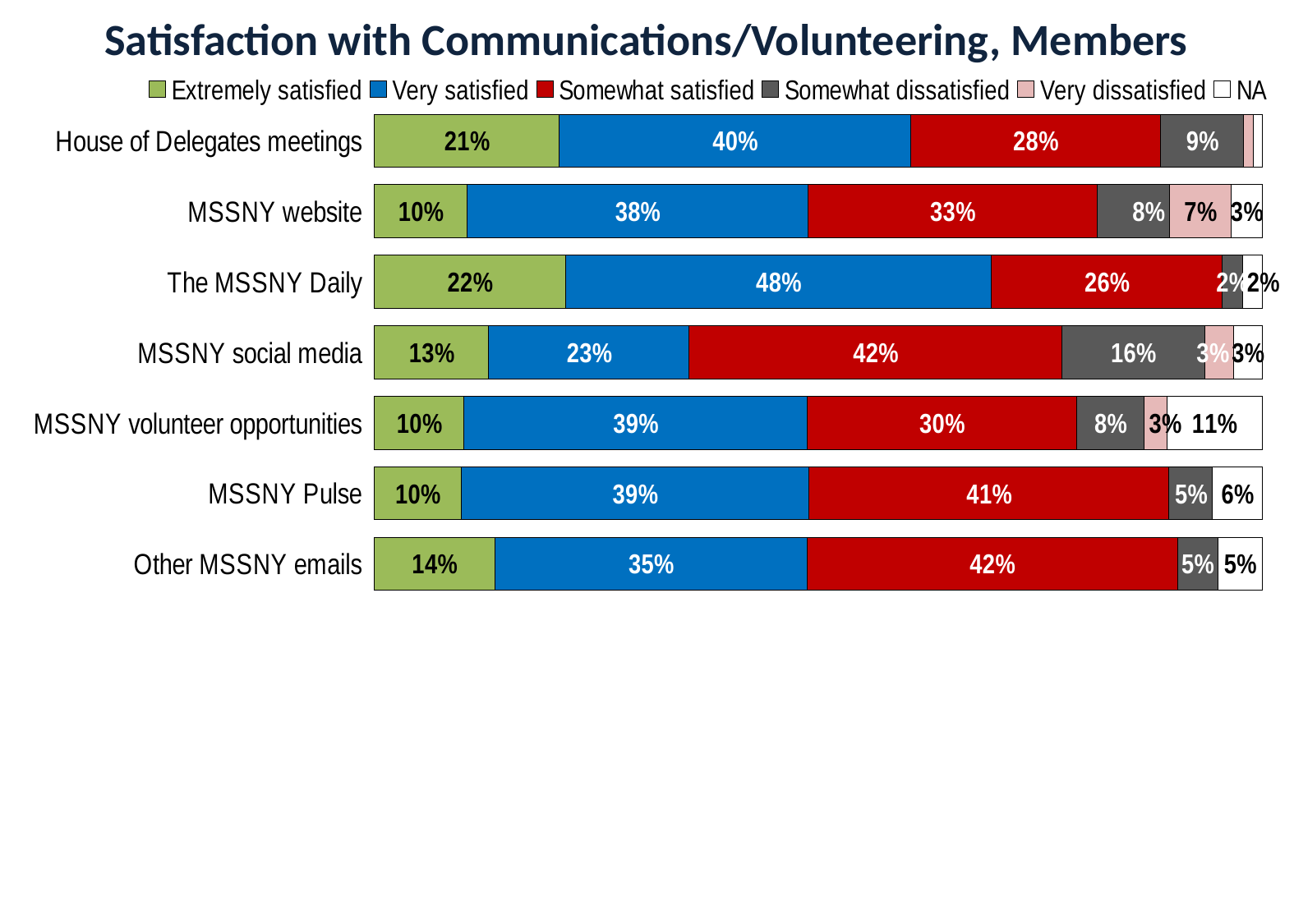
What percentage of members were very satisfied with The MSSNY Daily? 48% Which item has the highest percentage of somewhat dissatisfied members? MSSNY social media How many items are listed on the chart? 7 What percentage of members were very dissatisfied with the MSSNY website? 7% Which item has the lowest percentage of very satisfied members? MSSNY social media How many series does the legend list? 6 What kind of chart is shown on the slide? Stacked bar chart What is the difference in the somewhat satisfied percentage between MSSNY Pulse and House of Delegates meetings? 13 percentage points Which has a higher very satisfied percentage, House of Delegates meetings or the MSSNY website? House of Delegates meetings Which item has the highest percentage of extremely satisfied members? The MSSNY Daily What percentage of members were somewhat dissatisfied with MSSNY social media? 16% What is the NA percentage for MSSNY volunteer opportunities? 11%